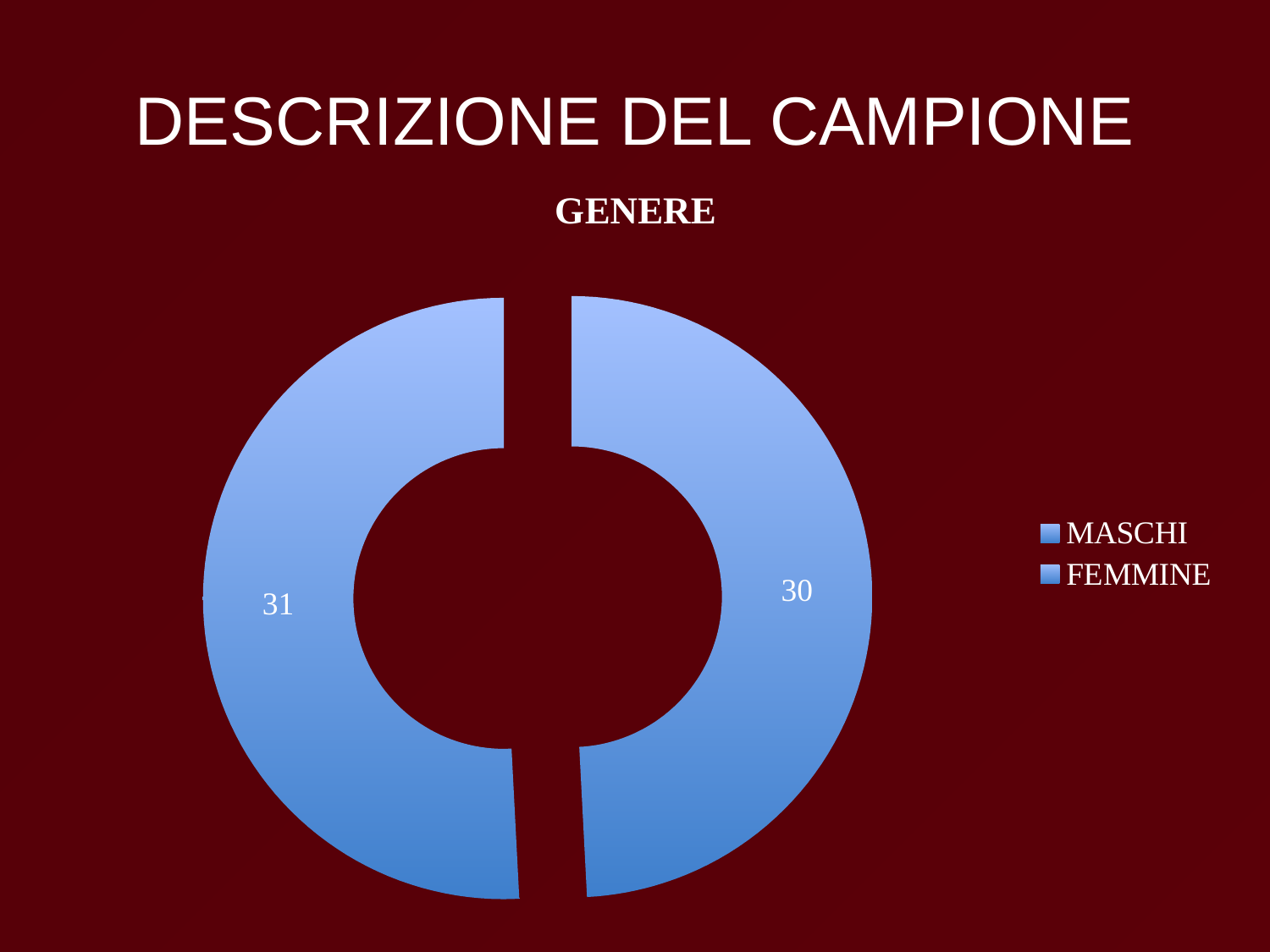
What is the title of the chart? GENERE How many slices does the doughnut chart have? 2 What is the difference between the two values shown on the chart? 1 What kind of chart is shown on the slide? doughnut chart What value is printed on the left slice of the doughnut chart? 31 What is the largest value shown on the chart? 31 How many entries does the chart legend list? 2 Which slice has the larger value, the left one or the right one? the left one What is the smallest value shown on the chart? 30 What is the total of the two values shown on the chart? 61 What value is printed on the right slice of the doughnut chart? 30 What are the two entries listed in the chart legend? MASCHI and FEMMINE